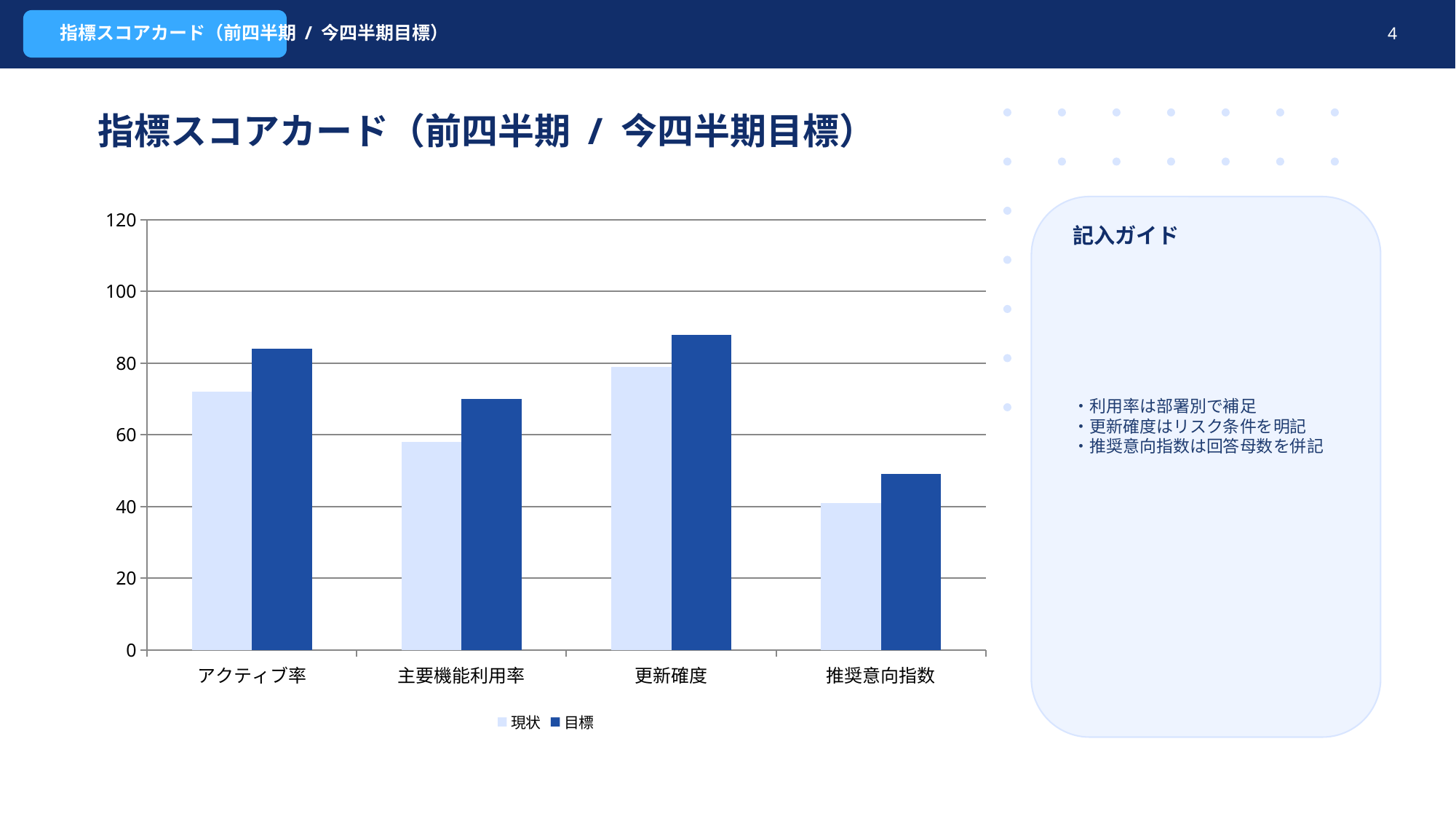
What kind of chart is shown on the slide? Bar chart How many categories are shown on the x axis of the chart? 4 Which category has the highest 目標 value? 更新確度 Which category has the highest 現状 value? 更新確度 Is the 現状 value for アクティブ率 greater or less than 60? greater Which is larger, the 目標 value for アクティブ率 or the 目標 value for 主要機能利用率? アクティブ率 Is the 目標 value for 更新確度 greater or less than 80? greater How many series does the chart legend list? 2 Which category has the lowest 目標 value? 推奨意向指数 What are the two series named in the chart legend? 現状 and 目標 Is the 現状 value for 推奨意向指数 greater or less than 60? less Which category has the lowest 現状 value? 推奨意向指数